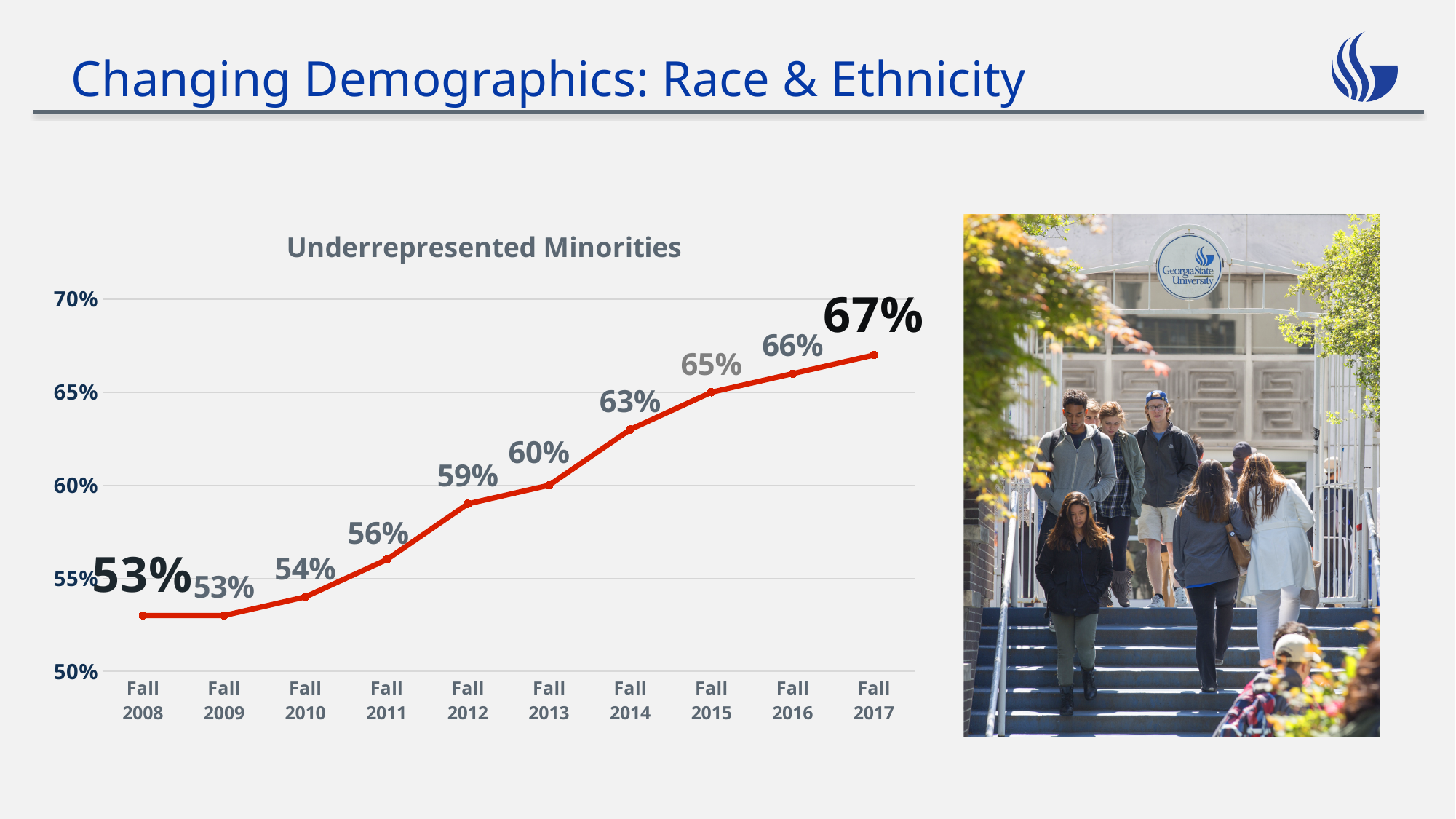
What is the value for Fall 2008? 53% Which year has the highest value? Fall 2017 Do the values rise or fall from Fall 2008 to Fall 2017? rise What is the title of the chart? Underrepresented Minorities What kind of chart is shown? line chart What is the value for Fall 2012? 59% Which is larger, the value for Fall 2011 or the value for Fall 2013? Fall 2013 What is the value for Fall 2017? 67% What is the difference between the Fall 2017 value and the Fall 2008 value? 14% How many data points are plotted on the chart? 10 What is the value for Fall 2014? 63% Is the value for Fall 2015 greater or less than 60%? greater